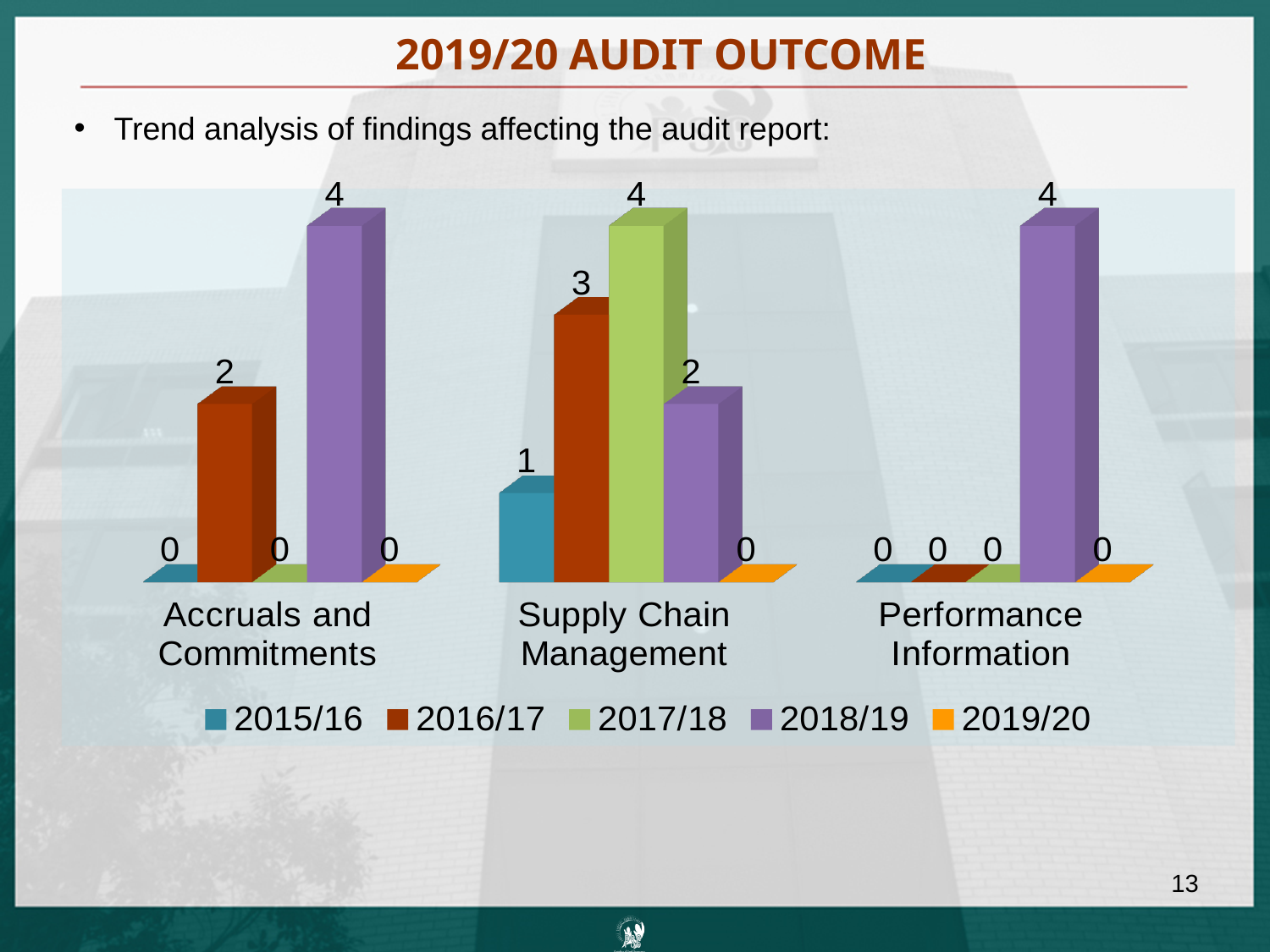
What is the difference between the 2016/17 and 2018/19 values in the Supply Chain Management category? 1 What is the value for 2016/17 in the Accruals and Commitments category? 2 How many categories are shown on the x axis of the chart? 3 What is the value for 2017/18 in the Supply Chain Management category? 4 Which is larger in the Accruals and Commitments category: the 2016/17 value or the 2018/19 value? 2018/19 What is the value for 2019/20 in the Supply Chain Management category? 0 What is the value for 2015/16 in the Supply Chain Management category? 1 Which year has the highest value in the Supply Chain Management category? 2017/18 What kind of chart is shown on the slide? Bar chart How many series does the legend list? 5 What is the value for 2018/19 in the Performance Information category? 4 Which year has the highest value in the Accruals and Commitments category? 2018/19